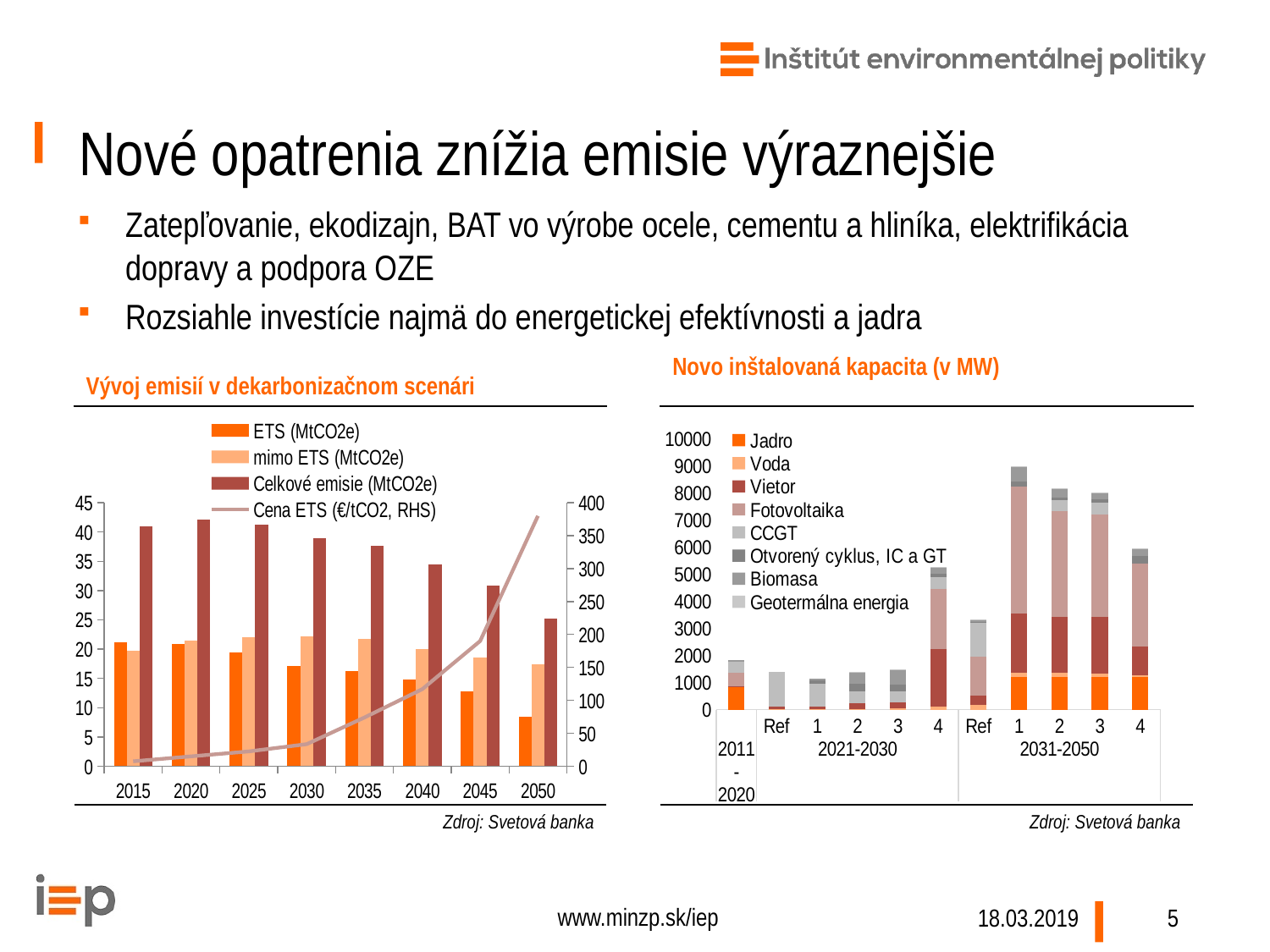
In the right chart 'Novo inštalovaná kapacita (v MW)', is the total for scenario 1 in 2031-2050 greater or less than 8000? greater In the left chart 'Vývoj emisií v dekarbonizačnom scenári', is the ETS value for 2050 greater or less than 10? less What kind of chart is the 'Vývoj emisií v dekarbonizačnom scenári' chart on the left? Bar chart with a line In the left chart 'Vývoj emisií v dekarbonizačnom scenári', is the Cena ETS value for 2050 greater or less than 350? greater In the left chart 'Vývoj emisií v dekarbonizačnom scenári', which year has the lowest Celkové emisie bar? 2050 How many series does the legend of the left chart 'Vývoj emisií v dekarbonizačnom scenári' list? 4 In the right chart 'Novo inštalovaná kapacita (v MW)', which bar is the tallest? Scenario 1 in 2031-2050 In the left chart 'Vývoj emisií v dekarbonizačnom scenári', does the Cena ETS line rise or fall from 2015 to 2050? Rise How many years are shown on the x axis of the left chart 'Vývoj emisií v dekarbonizačnom scenári'? 8 How many series does the legend of the right chart 'Novo inštalovaná kapacita (v MW)' list? 8 In the right chart 'Novo inštalovaná kapacita (v MW)', which is larger in 2031-2050: the Ref bar or the scenario 1 bar? Scenario 1 In the left chart 'Vývoj emisií v dekarbonizačnom scenári', which is larger: Celkové emisie in 2015 or in 2050? 2015